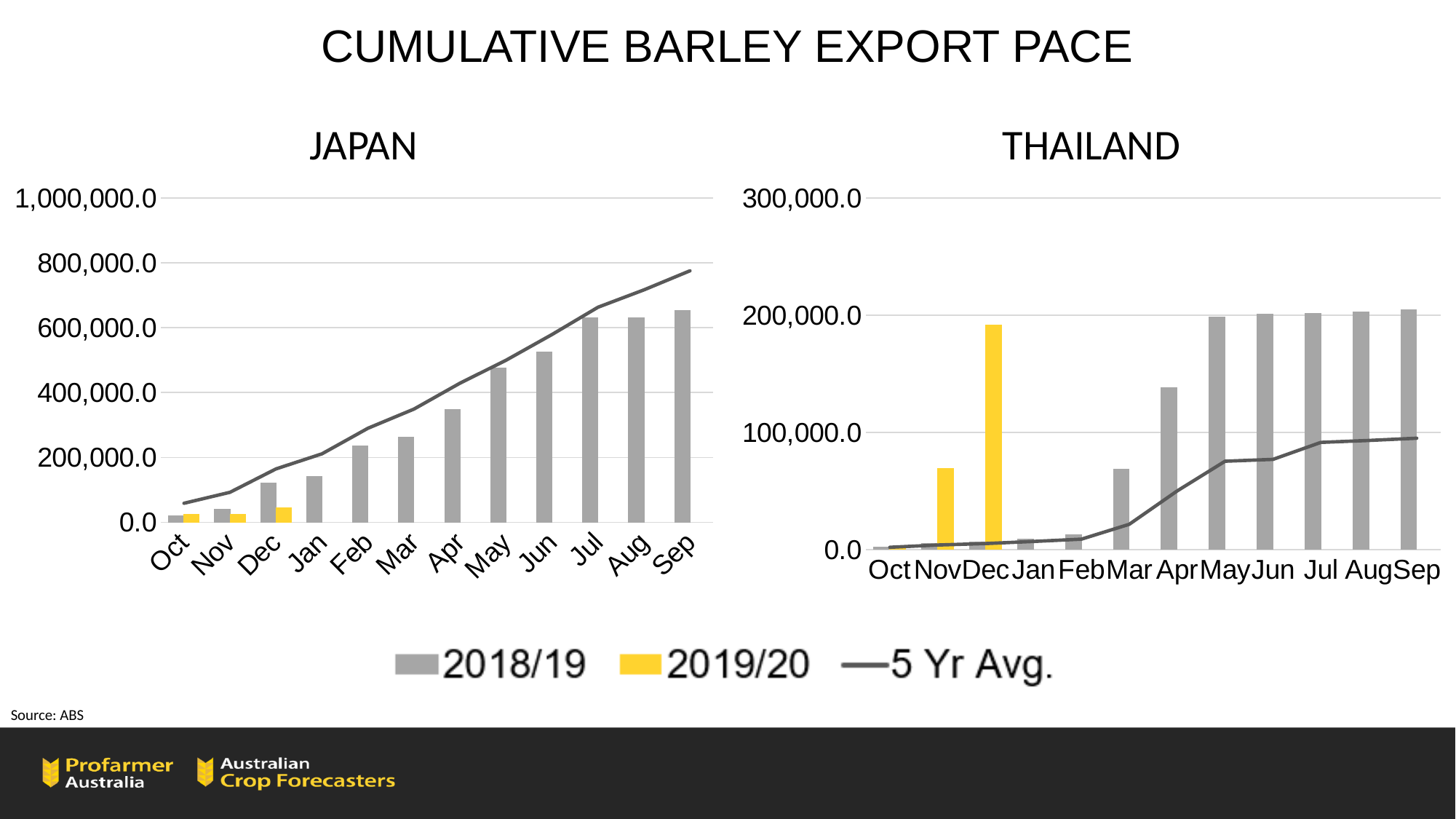
What kind of chart is the JAPAN chart? bar chart with a line How many months are shown on the x axis of the THAILAND chart? 12 In the JAPAN chart, which month has the lowest 2018/19 bar? Oct In the JAPAN chart, is the 2018/19 value for Sep greater or less than 600,000.0? greater In the THAILAND chart, which month has the highest 2019/20 bar? Dec In the JAPAN chart, which month has the highest 2018/19 bar? Sep In the THAILAND chart, is the 2018/19 value for Apr greater or less than 100,000.0? greater In the THAILAND chart, is the 5 Yr Avg value for Sep greater or less than 100,000.0? less In the THAILAND chart, which is larger for Dec: the 2018/19 bar or the 2019/20 bar? 2019/20 How many series does the legend list? 3 In the JAPAN chart, do the 2018/19 bars rise or fall from Oct to Sep? rise